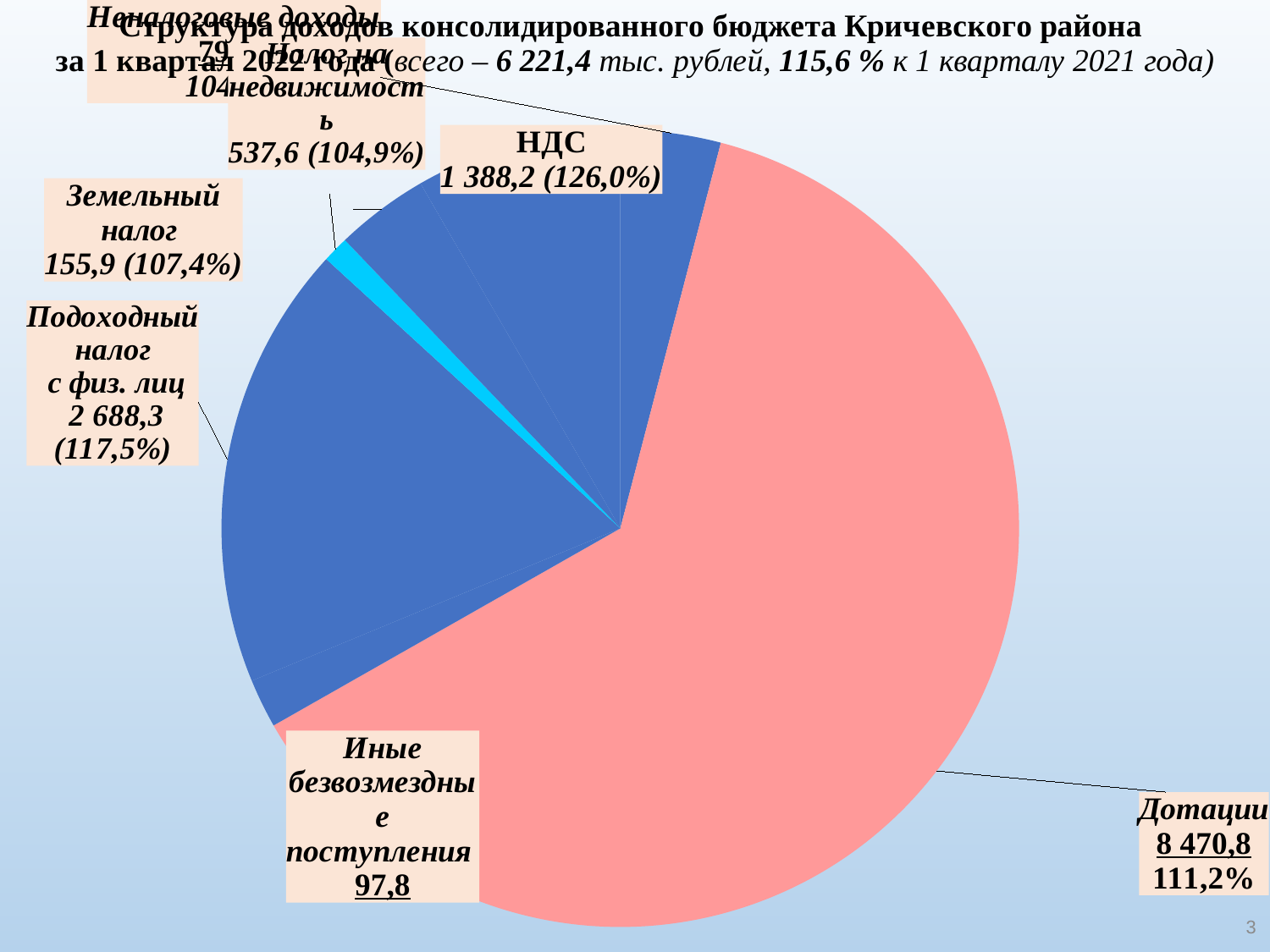
What colour is the Дотации slice? Pink What value is shown for Земельный налог? 155,9 What value is shown for Иные безвозмездные поступления? 97,8 What value is shown for НДС? 1 388,2 What value is shown for Налог на недвижимость? 537,6 What value is shown for Подоходный налог с физ. лиц? 2 688,3 Which is larger, the value for Налог на недвижимость or the value for Земельный налог? Налог на недвижимость What value is shown for Дотации? 8 470,8 What kind of chart is shown on the slide? Pie chart What is the difference between the values for Подоходный налог с физ. лиц and НДС? 1 300,1 Which category has the largest slice of the pie? Дотации What percentage relative to the previous year is shown for НДС? 126,0%